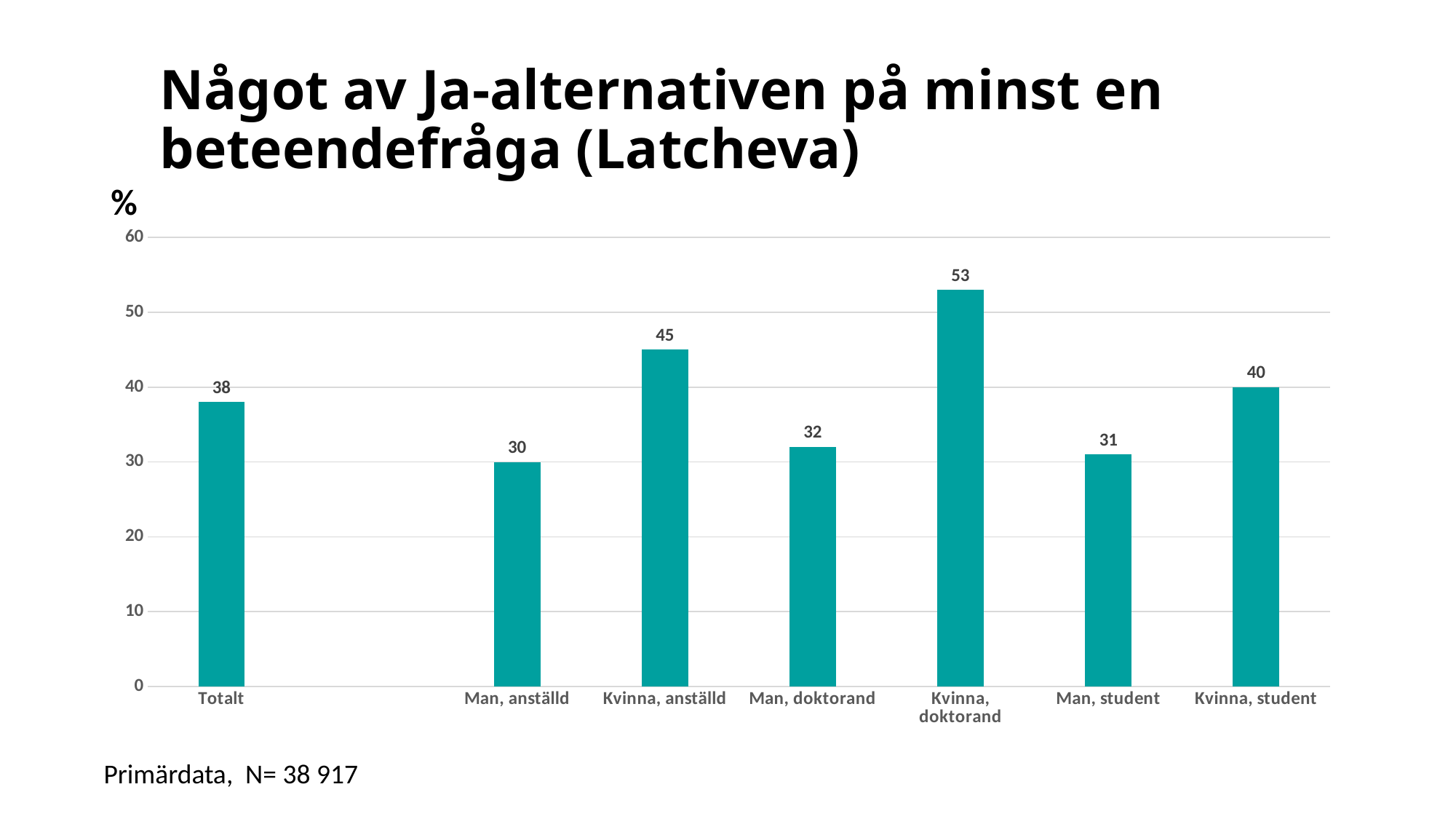
What is the value for Kvinna, doktorand? 53 Which is larger, the value for Kvinna, student or the value for Man, doktorand? Kvinna, student What is the N stated in the note below the chart? 38 917 Which category has the lowest value? Man, anställd Which category has the highest value? Kvinna, doktorand What kind of chart is shown on the slide? bar chart What is the difference between the values for Kvinna, anställd and Man, anställd? 15 What is the value for Totalt? 38 What is the title of the chart? Något av Ja-alternativen på minst en beteendefråga (Latcheva) How many categories are shown on the x axis? 7 What is the value for Man, student? 31 Is the value for Kvinna, doktorand greater or less than 50? greater